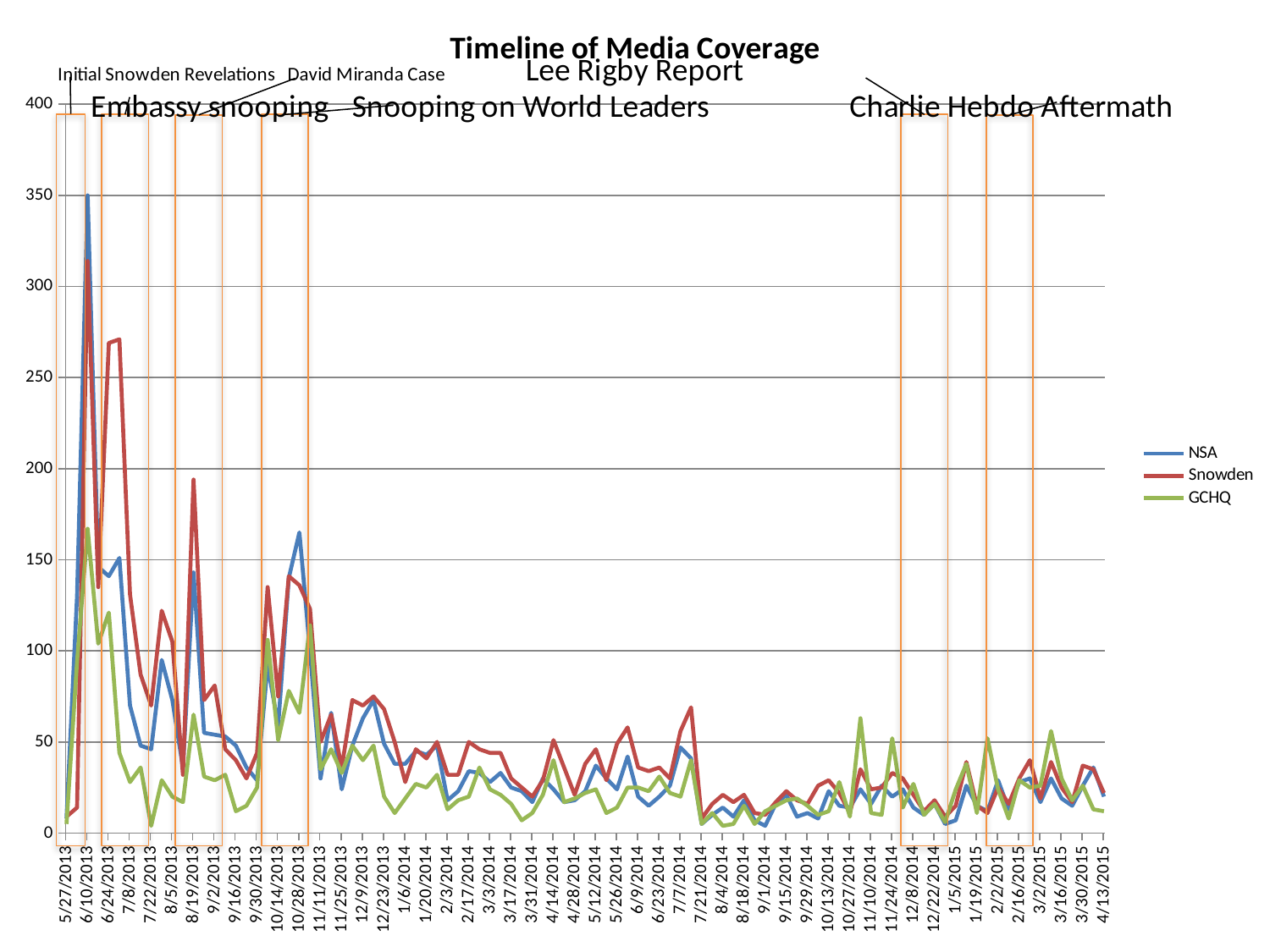
What is the title of the chart? Timeline of Media Coverage Which series has the lowest peak value on the chart? GCHQ Is the value for GCHQ on 6/10/2013 greater or less than 100? greater What colour is the line for the Snowden series? red What kind of chart is shown on the slide? line chart Is the value for NSA on 6/10/2013 greater or less than 300? greater Is the value for Snowden on 7/8/2013 greater or less than 250? less Overall, do the values rise or fall from mid-2013 to 2015? fall On 8/19/2013, which series has the larger value, Snowden or GCHQ? Snowden Which series reaches the highest value on the chart? NSA How many series does the legend list? 3 On 7/8/2013, which series has the larger value, Snowden or NSA? Snowden